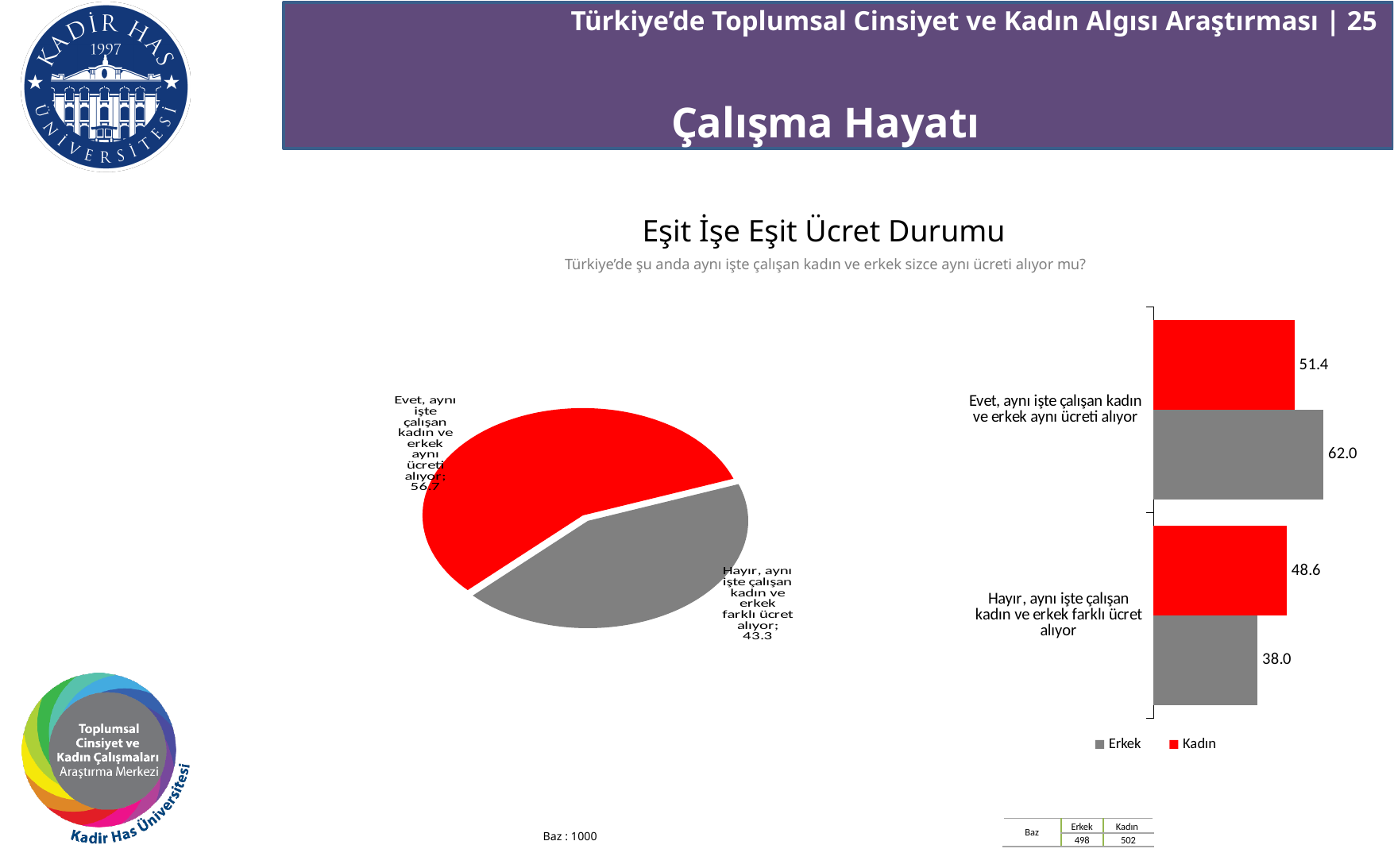
In the bar chart on the right, what is the Erkek value for "Hayır, aynı işte çalışan kadın ve erkek farklı ücret alıyor"? 38.0 What kind of chart is the chart on the right of the slide? Bar chart In the pie chart on the left, what share is labelled for "Evet, aynı işte çalışan kadın ve erkek aynı ücreti alıyor"? 56.7 In the bar chart on the right, which series has the higher value for "Hayır, aynı işte çalışan kadın ve erkek farklı ücret alıyor", Erkek or Kadın? Kadın In the pie chart on the left, which slice is larger, "Evet" or "Hayır"? Evet In the bar chart on the right, which colour represents the Kadın series? Red In the bar chart on the right, how many series does the legend list? 2 What kind of chart is the chart on the left of the slide? Pie chart In the pie chart on the left, how many slices are there? 2 In the pie chart on the left, what share is labelled for "Hayır, aynı işte çalışan kadın ve erkek farklı ücret alıyor"? 43.3 In the bar chart on the right, what is the difference between the Erkek and Kadın values for "Evet, aynı işte çalışan kadın ve erkek aynı ücreti alıyor"? 10.6 In the bar chart on the right, what is the Kadın value for "Evet, aynı işte çalışan kadın ve erkek aynı ücreti alıyor"? 51.4